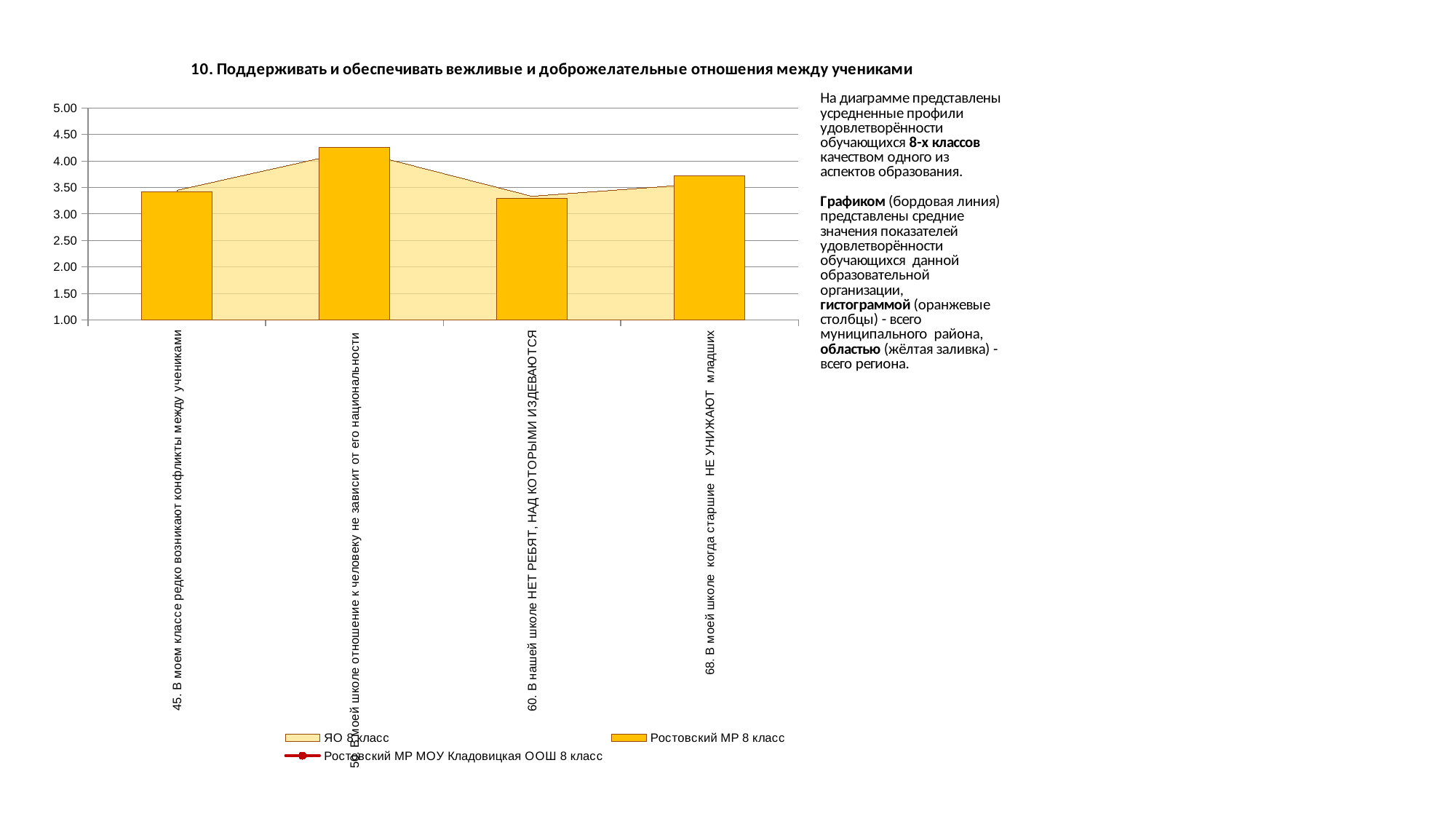
What colour represents the 'ЯО 8 класс' series in the legend? yellow Which has the larger Ростовский МР 8 класс value: '45. В моем классе редко возникают конфликты между учениками' or '68. В моей школе когда старшие НЕ УНИЖАЮТ младших'? 68. В моей школе когда старшие НЕ УНИЖАЮТ младших What is the title of the chart? 10. Поддерживать и обеспечивать вежливые и доброжелательные отношения между учениками Is the Ростовский МР 8 класс value for '45. В моем классе редко возникают конфликты между учениками' greater or less than 3.00? greater Which category has the lowest orange bar (Ростовский МР 8 класс)? 60. В нашей школе НЕТ РЕБЯТ, НАД КОТОРЫМИ ИЗДЕВАЮТСЯ Is the Ростовский МР 8 класс value for 'В моей школе отношение к человеку не зависит от его национальности' greater or less than 4.00? greater How many categories are shown on the x axis? 4 Is the Ростовский МР 8 класс value for '68. В моей школе когда старшие НЕ УНИЖАЮТ младших' greater or less than 3.50? greater What kind of chart is used for the 'Ростовский МР 8 класс' series? bar chart How many series does the legend list? 3 Which category has the highest orange bar (Ростовский МР 8 класс)? В моей школе отношение к человеку не зависит от его национальности